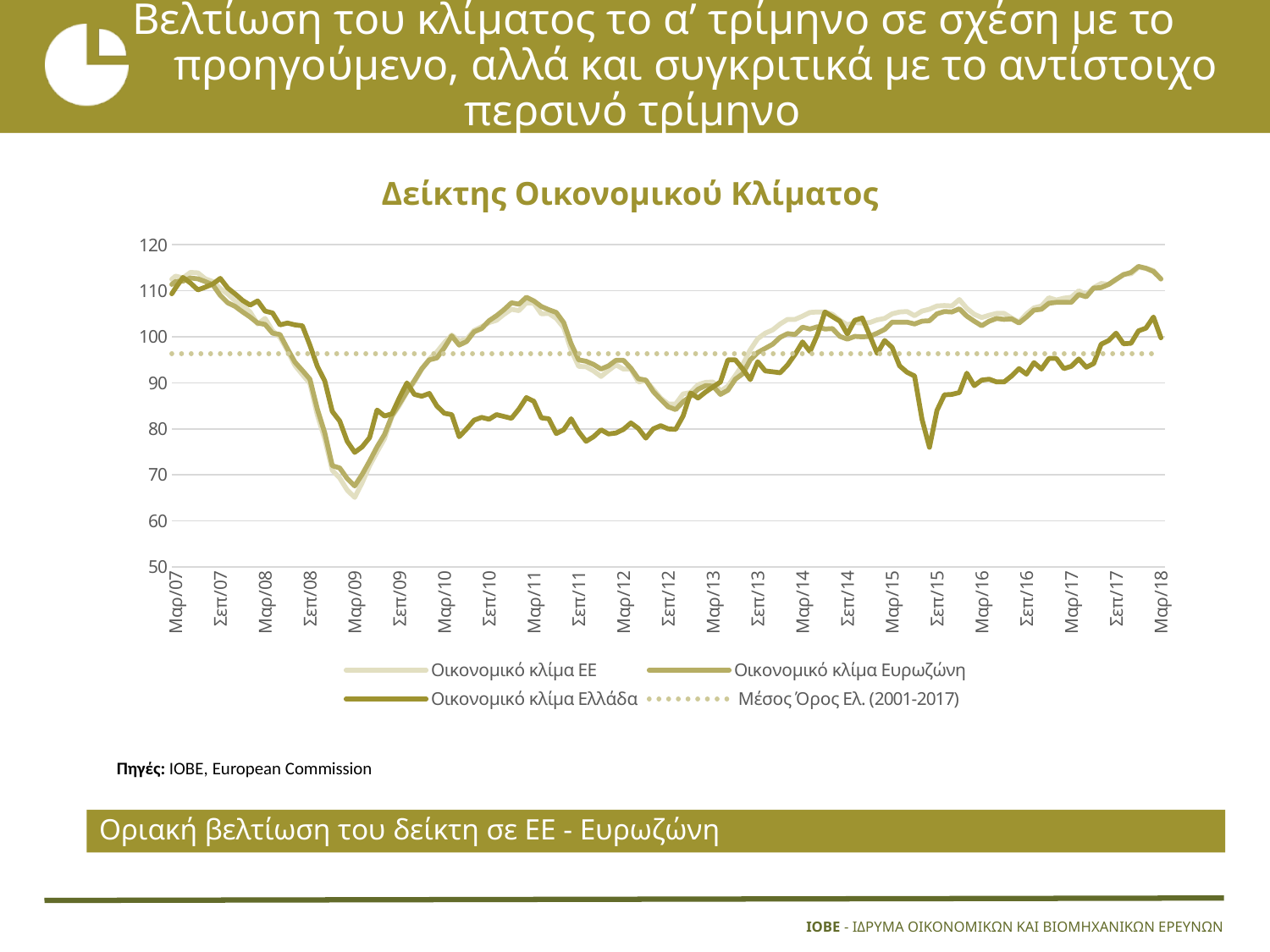
At Μαρ/09, which series has the higher value: Οικονομικό κλίμα Ελλάδα or Οικονομικό κλίμα ΕΕ? Οικονομικό κλίμα Ελλάδα What is the title of the chart? Δείκτης Οικονομικού Κλίματος How many series does the legend of the chart list? 4 Does Οικονομικό κλίμα Ελλάδα rise or fall between Μαρ/07 and Μαρ/09? fall Which series in the legend is drawn as a dotted line? Μέσος Όρος Ελ. (2001-2017) Is the dotted line Μέσος Όρος Ελ. (2001-2017) greater or less than 100? less At Σεπ/15, which series has the higher value: Οικονομικό κλίμα ΕΕ or Οικονομικό κλίμα Ελλάδα? Οικονομικό κλίμα ΕΕ Is the value of Οικονομικό κλίμα Ευρωζώνη at Μαρ/18 greater or less than 110? greater What kind of chart is shown on the slide? line chart Is the value of Οικονομικό κλίμα ΕΕ at Μαρ/09 greater or less than 70? less How many labels are shown on the x axis of the chart? 23